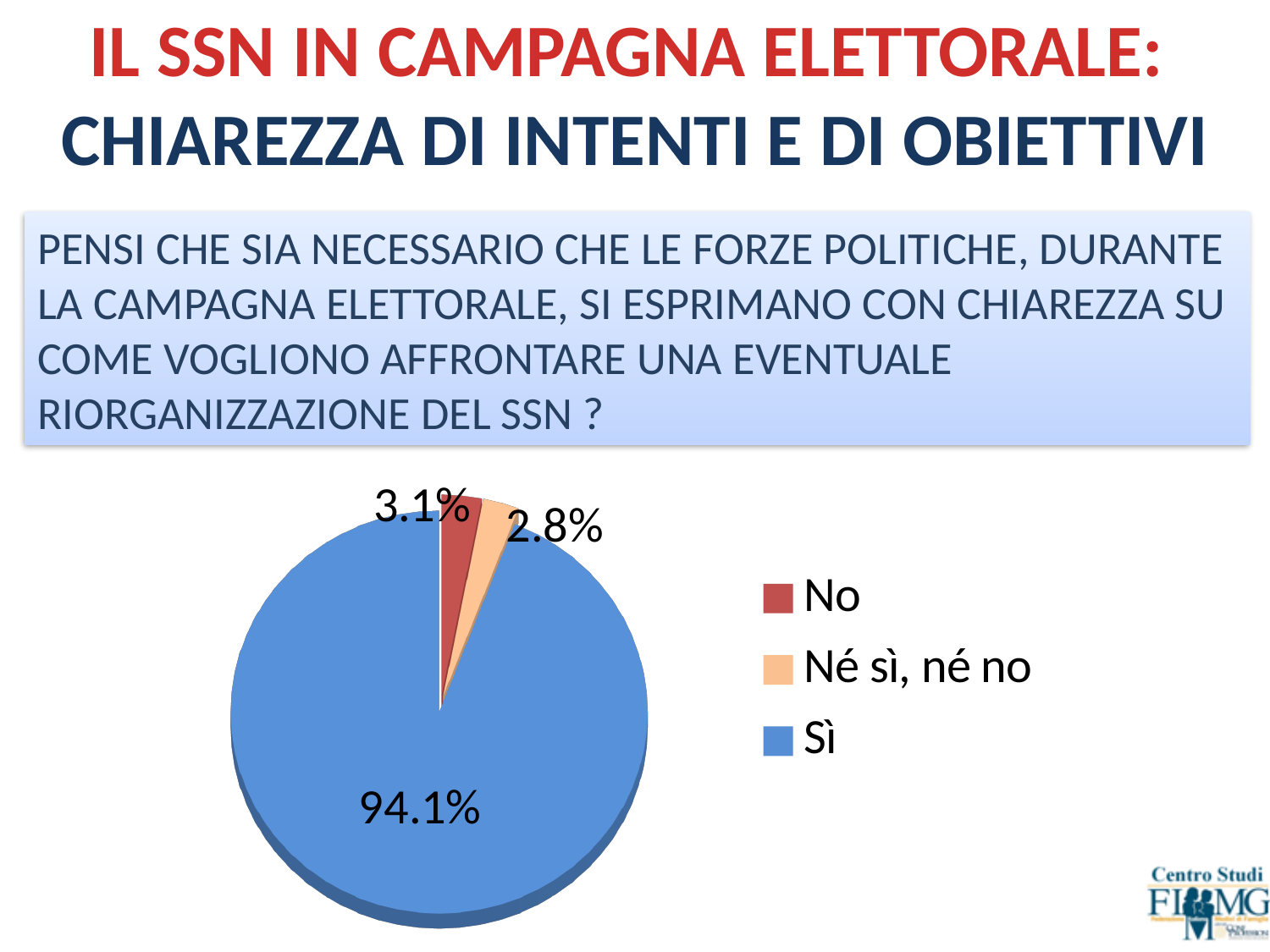
What kind of chart is shown on the slide? pie chart How many slices does the pie chart have? 3 What percentage of respondents answered "Sì"? 94.1% What percentage of respondents answered "Né sì, né no"? 2.8% Which colour represents "Sì" in the pie chart? blue What is the difference in percentage points between "No" and "Né sì, né no"? 0.3 percentage points How many entries does the legend list? 3 What percentage of respondents answered "No"? 3.1% Which response has the largest share of the pie? Sì Which response has the smallest share of the pie? Né sì, né no What is the difference in percentage points between "Sì" and "No"? 91 percentage points Which colour represents "No" in the pie chart? red